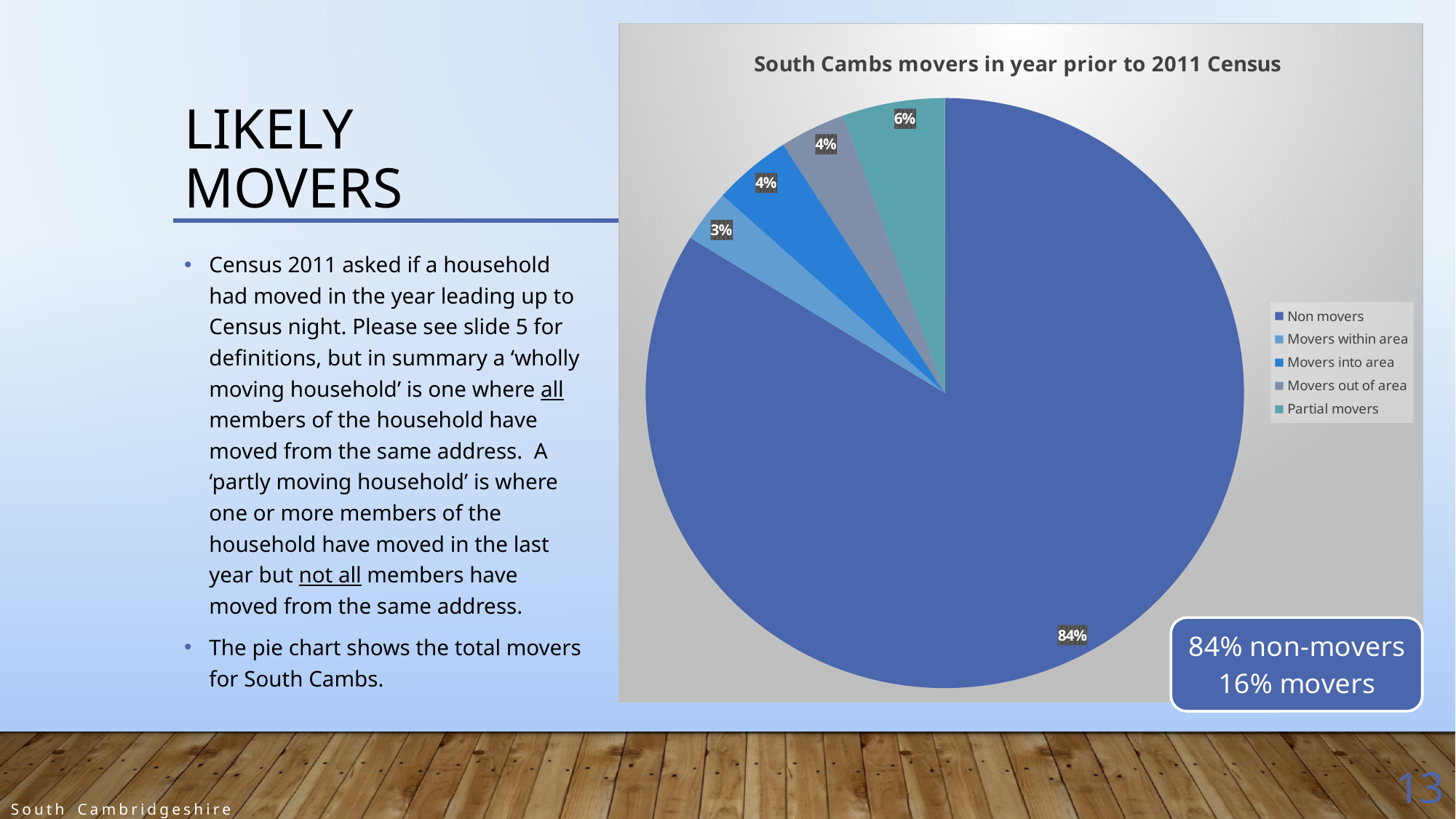
Which category has the largest slice of the pie? Non movers What percentage of the pie is Non movers? 84% Which category has the smallest slice of the pie? Movers within area What percentage of the pie is Movers into area? 4% Which is larger, the Partial movers slice or the Movers out of area slice? Partial movers What is the difference in percentage points between Non movers and Partial movers? 78 What percentage of the pie is Movers within area? 3% How many categories does the legend list? 5 What colour is the Partial movers slice? Teal What type of chart is shown on the slide? Pie chart What is the title of the chart? South Cambs movers in year prior to 2011 Census What percentage of the pie is Partial movers? 6%